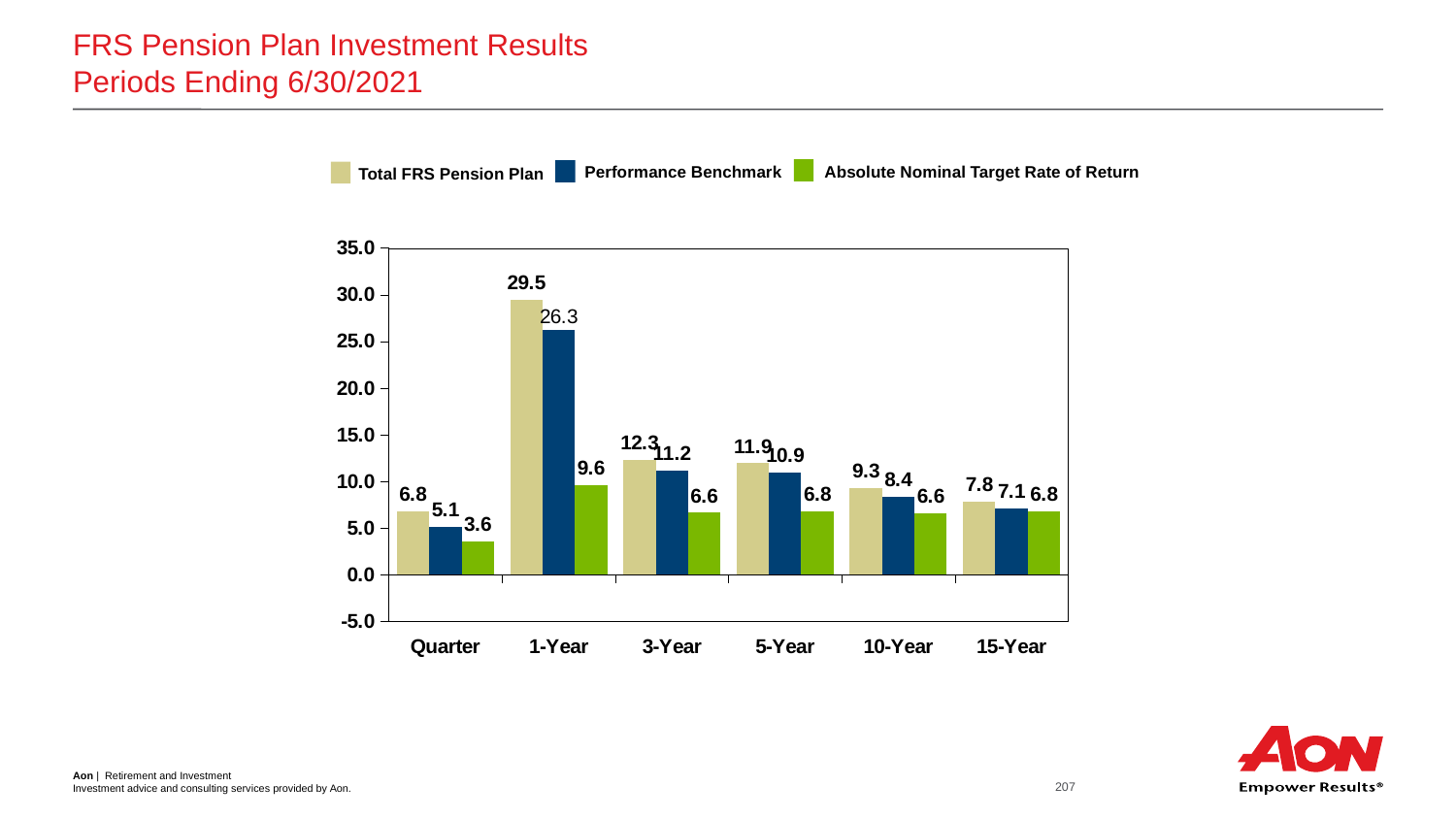
Which period has the lowest Absolute Nominal Target Rate of Return? Quarter How many series does the legend list? 3 What is the Performance Benchmark value for the Quarter period? 5.1 Which period has the highest Total FRS Pension Plan value? 1-Year How many periods are shown on the x axis? 6 What kind of chart is shown on the slide? Bar chart Which series is shown in green in the legend? Absolute Nominal Target Rate of Return What is the Total FRS Pension Plan value for the 1-Year period? 29.5 What is the difference between the Total FRS Pension Plan and the Performance Benchmark for the 1-Year period? 3.2 Which is larger for the 5-Year period: the Total FRS Pension Plan or the Performance Benchmark? Total FRS Pension Plan Is the Performance Benchmark value for the 1-Year period greater or less than 25.0? greater What is the Absolute Nominal Target Rate of Return for the 10-Year period? 6.6